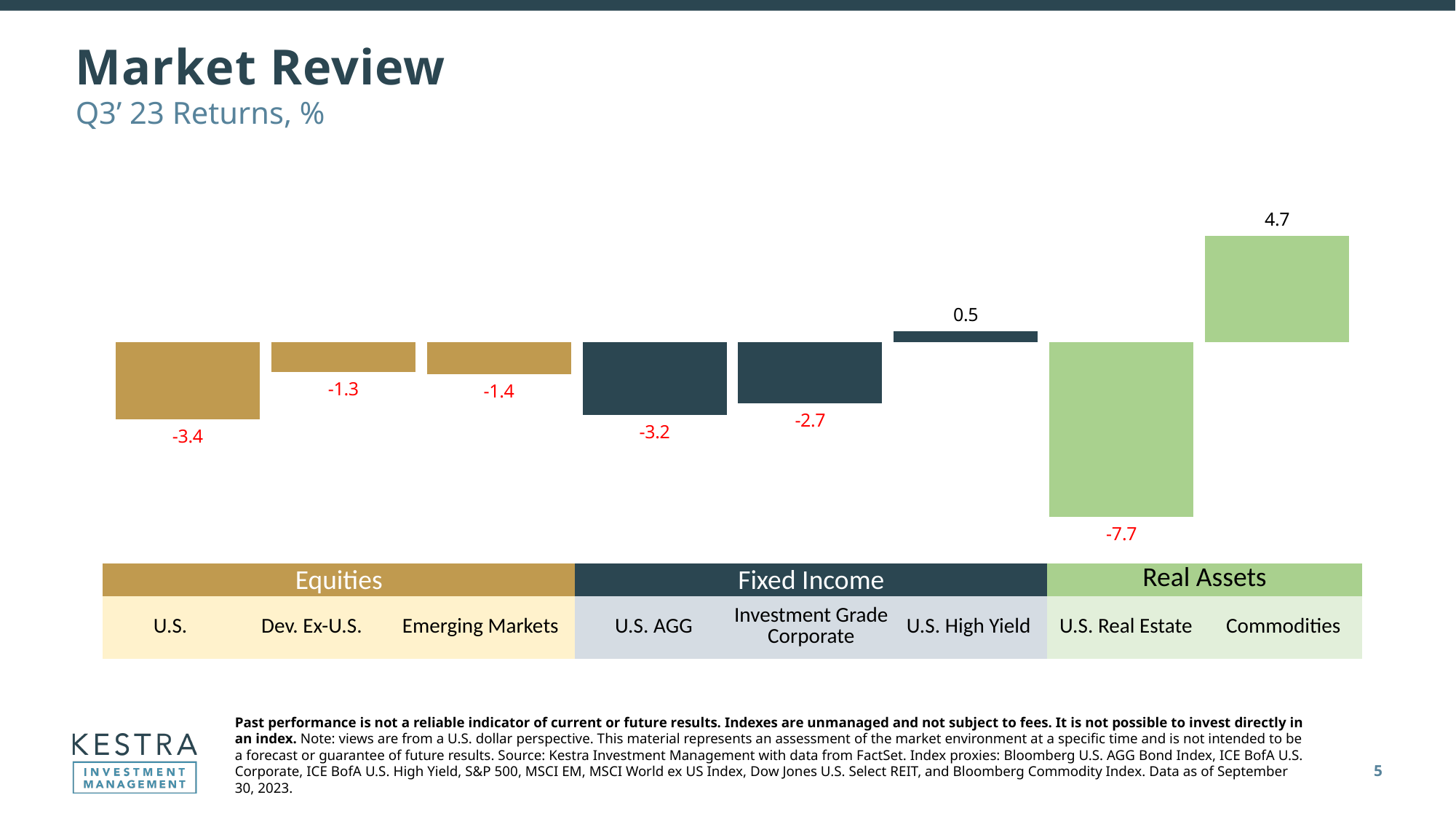
What is the Q3' 23 return for Commodities? 4.7 What kind of chart is shown on the slide? Bar chart Which group does the Emerging Markets category belong to? Equities Which has the larger Q3' 23 return, U.S. AGG or Investment Grade Corporate? Investment Grade Corporate What is the difference between the Commodities return and the U.S. Real Estate return? 12.4 How many categories are plotted in the chart? 8 What is the Q3' 23 return for U.S. High Yield? 0.5 What is the Q3' 23 return for U.S. Real Estate? -7.7 Which category has the lowest Q3' 23 return? U.S. Real Estate What is the Q3' 23 return for U.S. AGG? -3.2 Which category has the highest Q3' 23 return? Commodities How many asset class groups are the categories divided into? 3